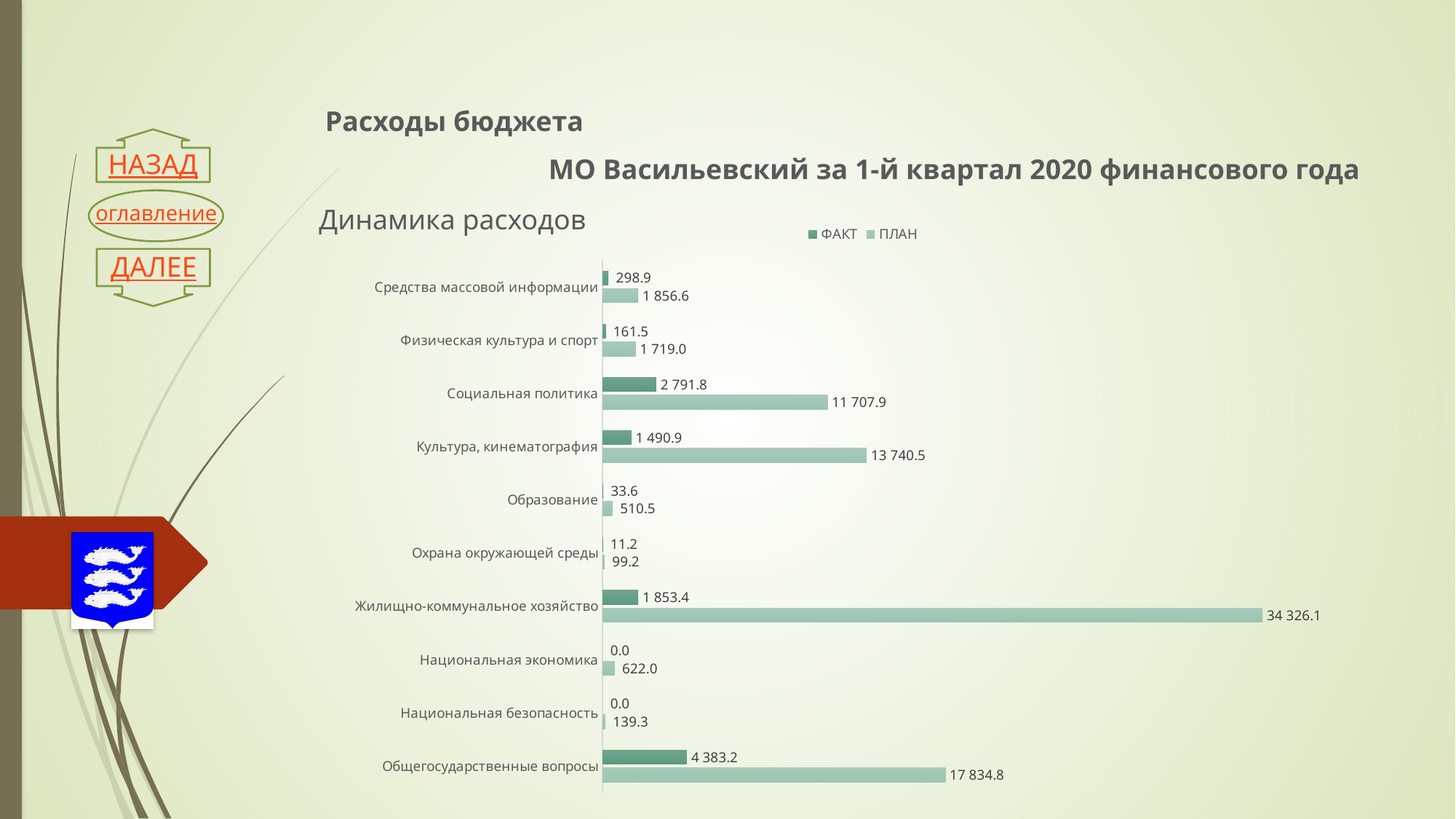
How many categories are shown on the chart? 10 What is the ПЛАН value for Культура, кинематография? 13 740.5 Which is larger: the ФАКТ value for Культура, кинематография or the ФАКТ value for Жилищно-коммунальное хозяйство? Жилищно-коммунальное хозяйство Which category has the lowest ПЛАН value? Охрана окружающей среды Which category has the highest ПЛАН value? Жилищно-коммунальное хозяйство What is the ФАКТ value for Национальная экономика? 0.0 What is the difference between the ПЛАН and ФАКТ values for Общегосударственные вопросы? 13 451.6 Which category has the highest ФАКТ value? Общегосударственные вопросы What type of chart is shown on the slide? bar chart How many series does the chart legend list? 2 What is the ФАКТ value for Социальная политика? 2 791.8 What is the ПЛАН value for Жилищно-коммунальное хозяйство? 34 326.1